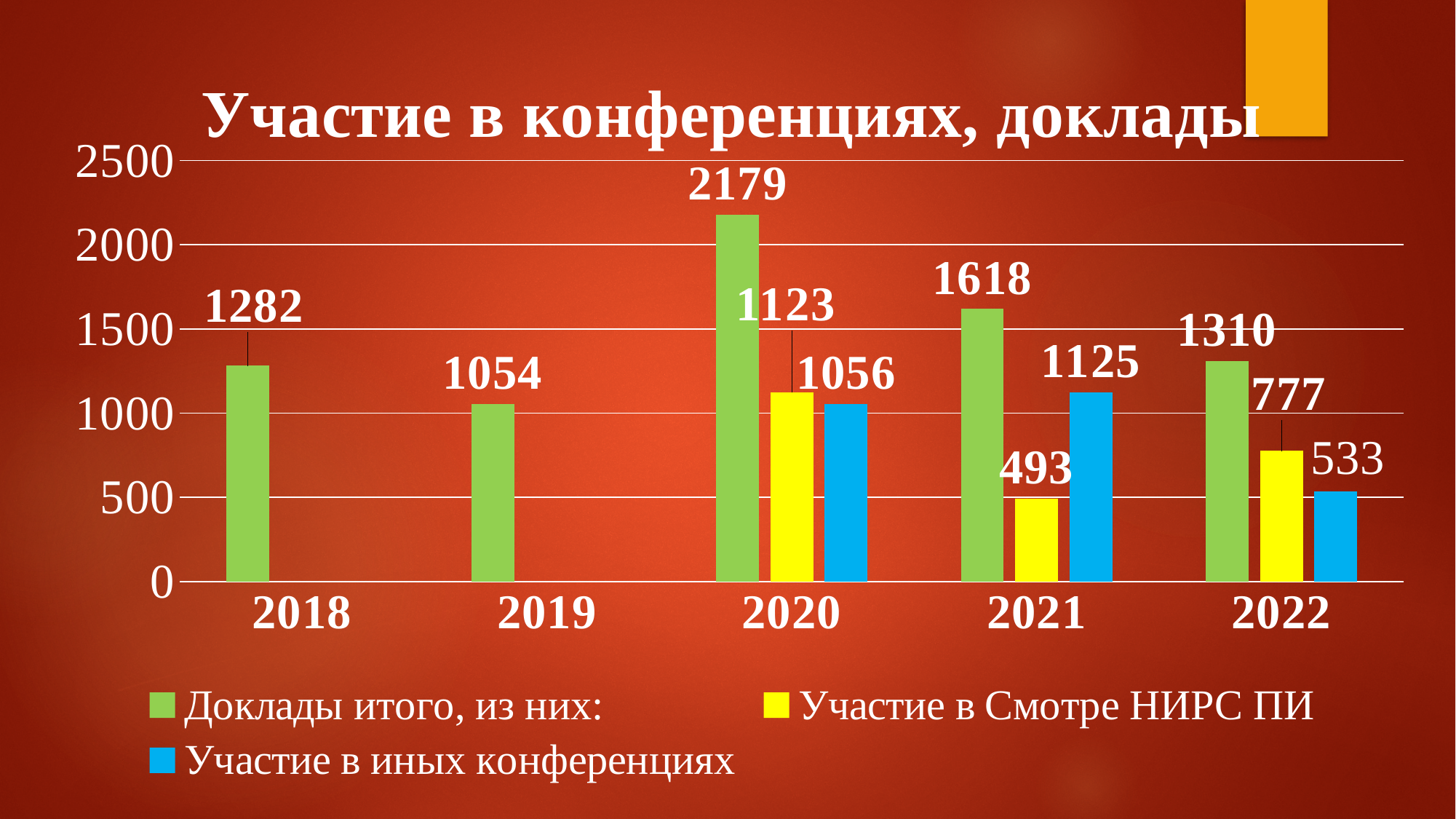
How many years are shown on the x axis? 5 What is the value of "Доклады итого, из них:" for 2020? 2179 In which year is "Доклады итого, из них:" lowest? 2019 Is the value of "Участие в Смотре НИРС ПИ" for 2022 greater or less than 1000? less In which year is "Доклады итого, из них:" highest? 2020 Which is larger in 2021: "Участие в Смотре НИРС ПИ" or "Участие в иных конференциях"? Участие в иных конференциях How many series does the legend list? 3 What is the value of "Участие в Смотре НИРС ПИ" for 2021? 493 What is the difference between "Доклады итого, из них:" in 2020 and in 2021? 561 What is the title of the chart? Участие в конференциях, доклады What is the value of "Участие в иных конференциях" for 2022? 533 What kind of chart is shown on the slide? bar chart